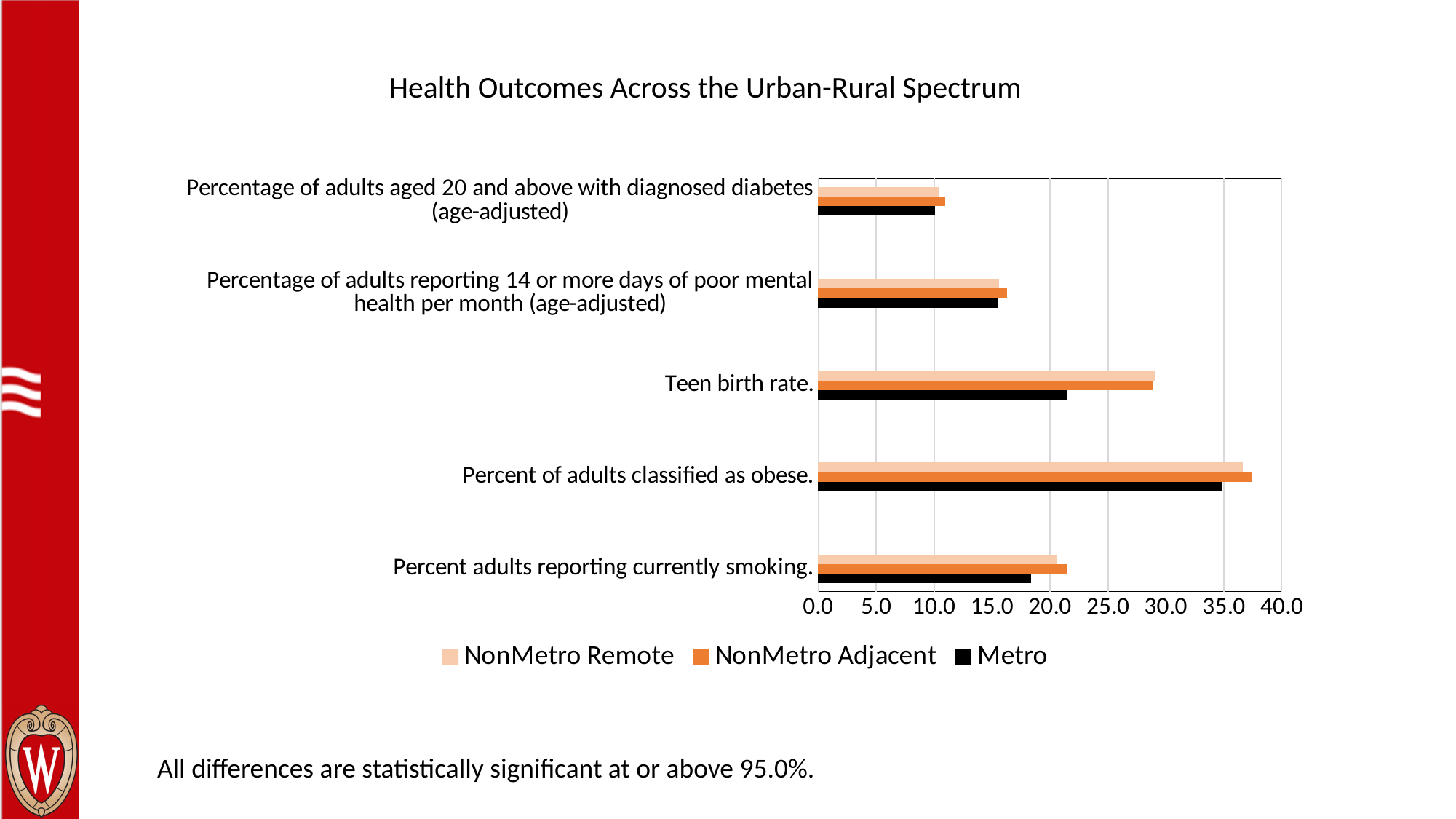
Is the NonMetro Remote value for Percentage of adults aged 20 and above with diagnosed diabetes (age-adjusted) greater or less than 15.0? less What is the title of the chart? Health Outcomes Across the Urban-Rural Spectrum Is the Metro value for Teen birth rate greater or less than 25.0? less Which category has the lowest value for the Metro series? Percentage of adults aged 20 and above with diagnosed diabetes (age-adjusted) What kind of chart is shown on the slide? bar chart How many series does the legend list? 3 Which category has the highest value for the Metro series? Percent of adults classified as obese. For Percent adults reporting currently smoking, which is larger: the Metro value or the NonMetro Adjacent value? NonMetro Adjacent Is the Metro value for Percent of adults classified as obese greater or less than 30.0? greater Which category has the highest value for the NonMetro Adjacent series? Percent of adults classified as obese. How many health outcome categories are plotted on the chart? 5 For Teen birth rate, which is larger: the Metro value or the NonMetro Remote value? NonMetro Remote